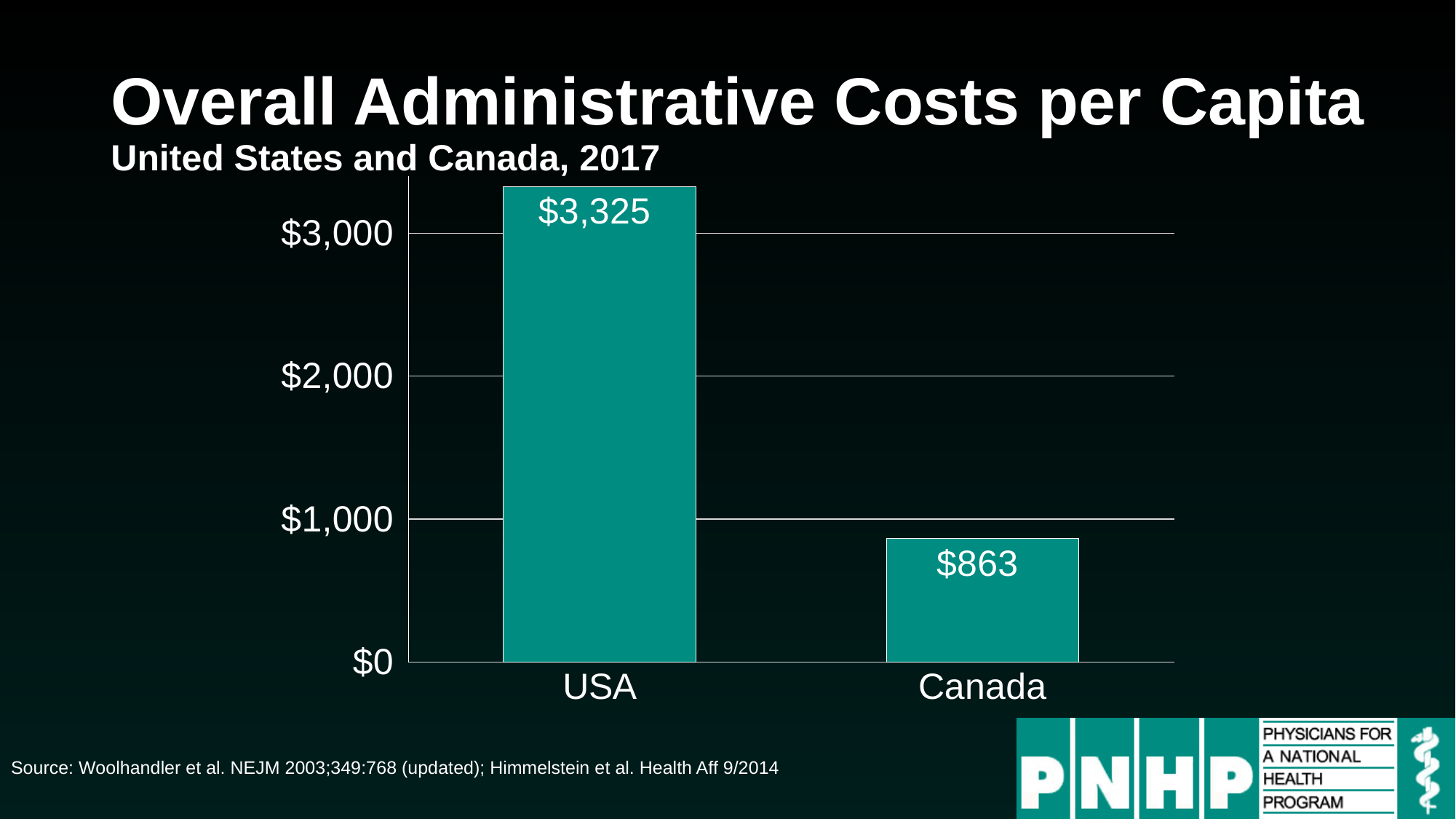
What type of chart is shown on the slide? Bar chart What is the title of the chart? Overall Administrative Costs per Capita Which country has the lower administrative cost per capita? Canada What is the overall administrative cost per capita for Canada? $863 Is the administrative cost per capita for the USA greater or less than $3,000? greater How many countries are shown in the chart? 2 Which country has the higher administrative cost per capita? USA What is the overall administrative cost per capita for the USA? $3,325 Is the administrative cost per capita for Canada greater or less than $1,000? less Which year does the chart's data refer to? 2017 What is the difference between the USA and Canada administrative costs per capita? $2,462